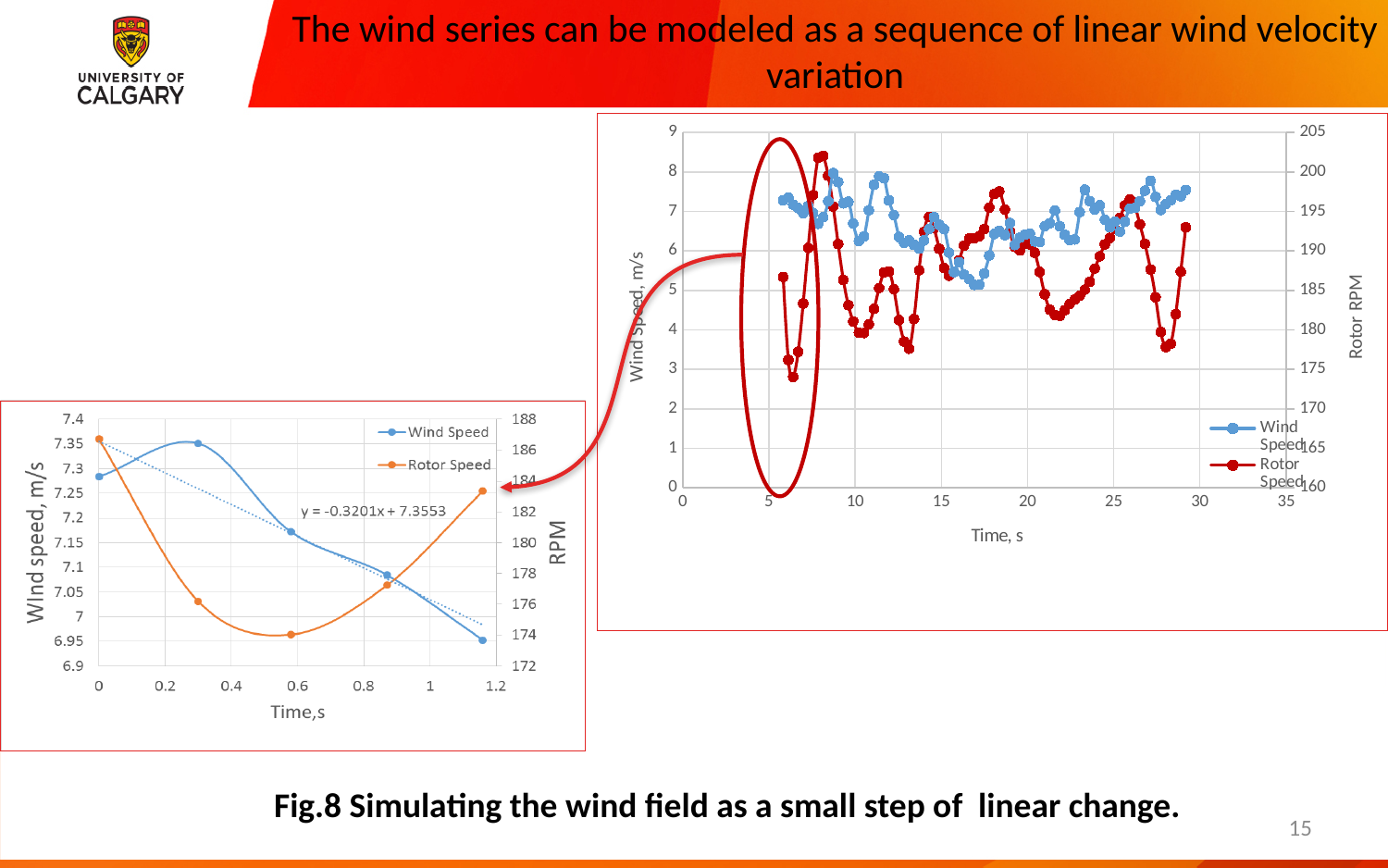
In the small chart on the bottom left, does the Wind Speed series overall rise or fall as time increases from 0 to 1.2 s? fall What are the two series named in the legend of the large chart on the right? Wind Speed and Rotor Speed In the small chart on the bottom left, is the Wind Speed value at time 1.16 s greater or less than 7? less In the large chart on the right, is the peak Rotor Speed value (near 8 s) greater or less than 200? greater In the small chart on the bottom left, is the Rotor Speed value at about 0.58 s greater or less than 176? less How many series does the legend of the small chart on the bottom left list? 2 In the small chart on the bottom left, what is the trendline equation shown? y = -0.3201x + 7.3553 In the small chart on the bottom left, at which time is the Wind Speed highest? 0.3 s In the small chart on the bottom left, how many data points does the Wind Speed series have? 5 In the small chart on the bottom left, which is larger: the Wind Speed at 0.3 s or at 1.16 s? at 0.3 s What kind of chart is the large chart on the right of the slide? line chart